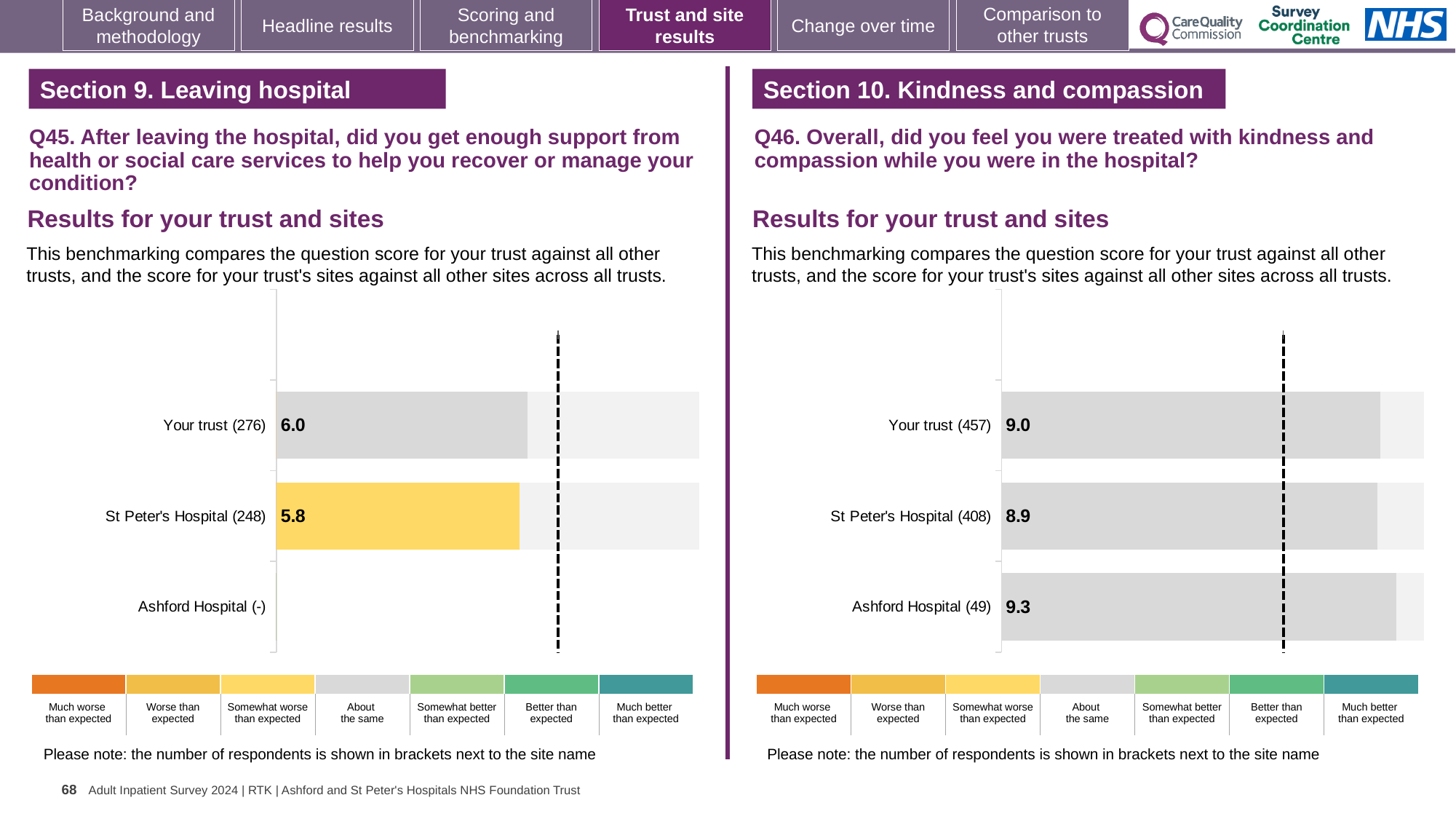
In the Q45 chart on the left, which has the larger score, Your trust or St Peter's Hospital? Your trust In the Q46 chart on the right, what is the score for St Peter's Hospital? 8.9 In the Q46 chart on the right, what is the score for Ashford Hospital? 9.3 What type of chart is used in the Q45 chart on the left? Bar chart In the Q46 chart on the right, which site or trust has the lowest score? St Peter's Hospital In the Q45 chart on the left, which benchmark category does the colour of the St Peter's Hospital bar indicate? Somewhat worse than expected In the Q45 chart on the left, what is the difference between the score for Your trust and the score for St Peter's Hospital? 0.2 In the Q46 chart on the right, how many respondents are shown for Your trust? 457 In the Q45 chart on the left, what is the score for St Peter's Hospital? 5.8 In the Q46 chart on the right, which site or trust has the highest score? Ashford Hospital In the Q45 chart on the left, what is the score for Your trust? 6.0 In the Q46 chart on the right, what is the difference between the score for Ashford Hospital and the score for Your trust? 0.3